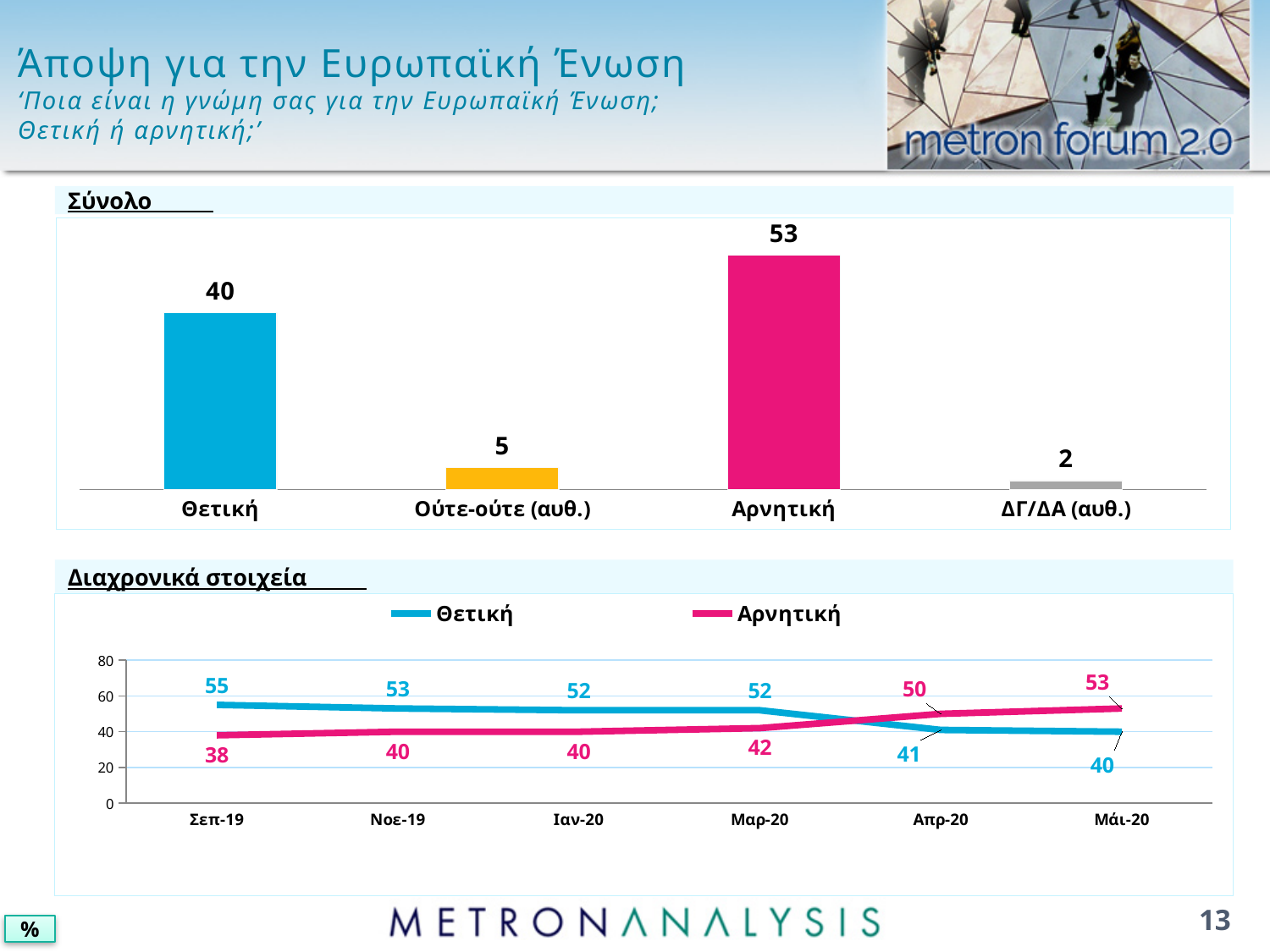
In the 'Σύνολο' bar chart, which category has the highest value? Αρνητική In the 'Σύνολο' bar chart, what is the difference between the values for Αρνητική and Θετική? 13 In the 'Σύνολο' bar chart, which category has the lowest value? ΔΓ/ΔΑ (αυθ.) In the 'Διαχρονικά στοιχεία' chart, what is the value for Θετική at Σεπ-19? 55 In the 'Σύνολο' bar chart, what is the value for Ούτε-ούτε (αυθ.)? 5 In the 'Διαχρονικά στοιχεία' chart, does the Αρνητική series rise or fall from Σεπ-19 to Μάι-20? Rise In the 'Σύνολο' bar chart, how many categories are shown? 4 In the 'Σύνολο' bar chart, what is the value for Αρνητική? 53 What kind of chart is the 'Σύνολο' chart? Bar chart In the 'Διαχρονικά στοιχεία' chart, what is the value for Αρνητική at Απρ-20? 50 In the 'Διαχρονικά στοιχεία' chart, how many series does the legend list? 2 In the 'Διαχρονικά στοιχεία' chart, which is larger at Μαρ-20: Θετική or Αρνητική? Θετική